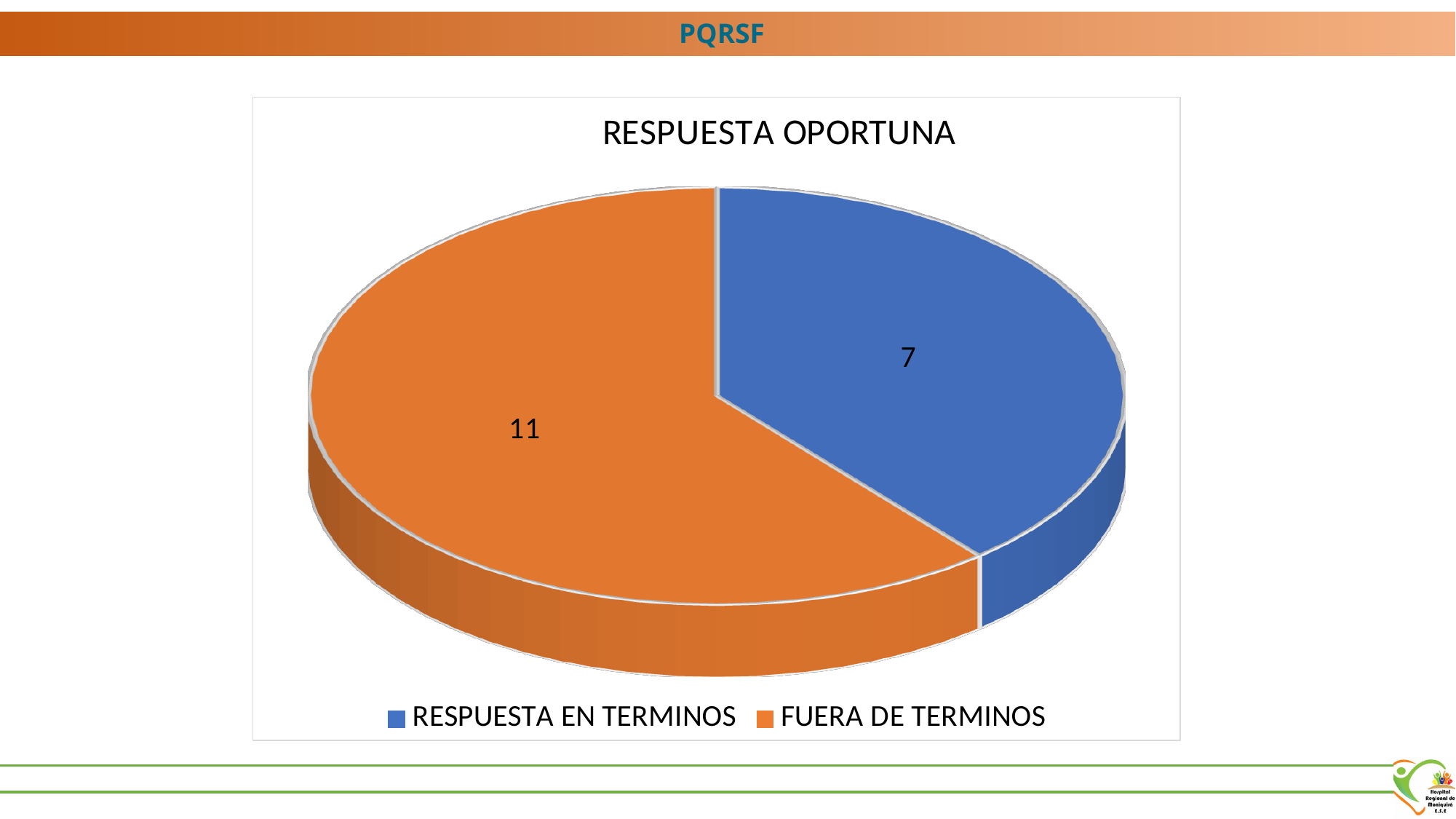
What colour is the slice for FUERA DE TERMINOS? Orange What is the total of the two slices in the pie chart? 18 Which category has the largest slice of the pie? FUERA DE TERMINOS What is the value for RESPUESTA EN TERMINOS? 7 Which is larger, RESPUESTA EN TERMINOS or FUERA DE TERMINOS? FUERA DE TERMINOS How many categories does the pie chart show? 2 Which category has the smallest slice of the pie? RESPUESTA EN TERMINOS What is the value for FUERA DE TERMINOS? 11 What is the title of the chart? RESPUESTA OPORTUNA What kind of chart is shown on the slide? Pie chart What is the difference between the values for FUERA DE TERMINOS and RESPUESTA EN TERMINOS? 4